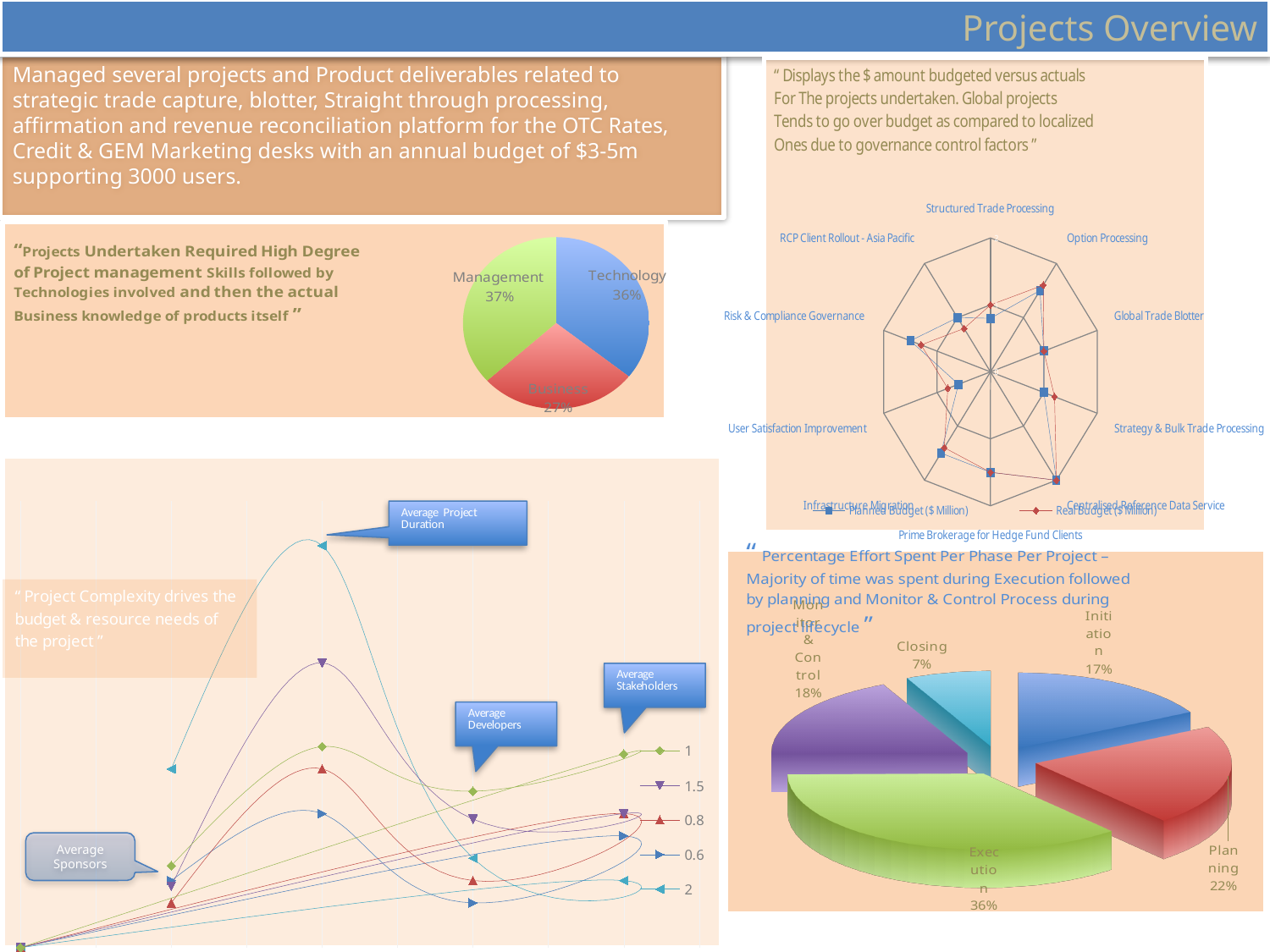
What kind of chart is the bottom-left chart? Line chart In the bottom-right pie chart, which is larger: Initiation or Monitor & Control? Monitor & Control In the bottom-right pie chart, what percentage of effort is spent on Execution? 36% In the top-left pie chart, what percentage is shown for Management? 37% How many slices does the top-left pie chart have? 3 How many categories are plotted on the top-right radar chart? 10 How many series does the legend of the top-right radar chart list? 2 In the bottom-right pie chart, what percentage of effort is spent on Closing? 7% In the bottom-right pie chart, which phase has the smallest share? Closing In the top-left pie chart, which slice has the largest share? Management In the top-left pie chart, what percentage is shown for Technology? 36% In the bottom-right pie chart, what is the difference between the Execution and Planning percentages? 14%